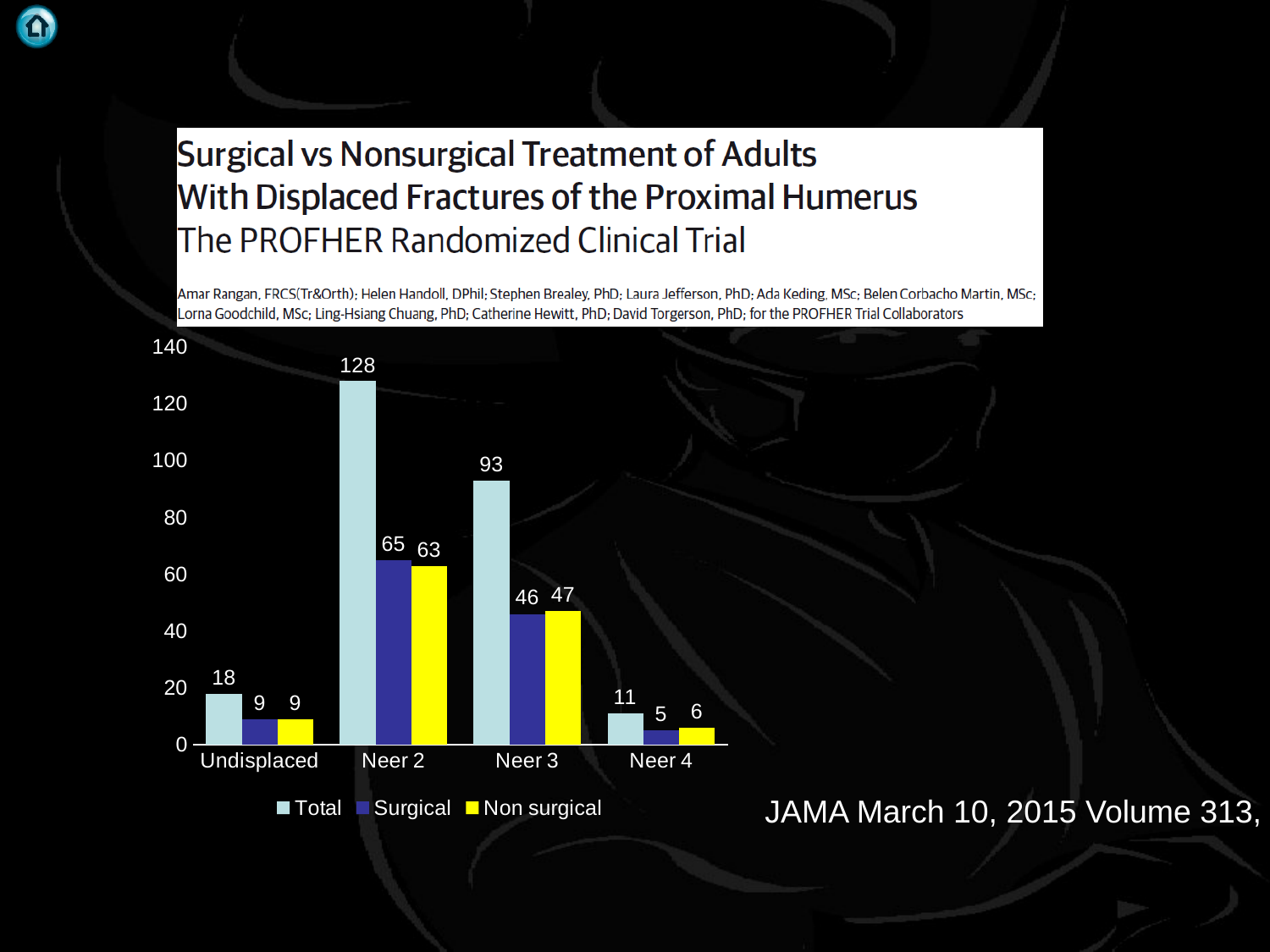
How many series does the legend list? 3 Which is larger for Neer 2: the Surgical value or the Non surgical value? Surgical Which colour represents the Non surgical series in the legend? yellow What is the Non surgical value for Neer 4? 6 Which category has the lowest Surgical value? Neer 4 What is the difference between the Total values for Neer 2 and Neer 3? 35 Which category has the highest Total value? Neer 2 How many categories are shown on the x axis? 4 What is the Total value for Neer 2? 128 What kind of chart is shown on the slide? bar chart What is the Surgical value for Neer 3? 46 Is the Total value for Neer 3 greater or less than 80? greater